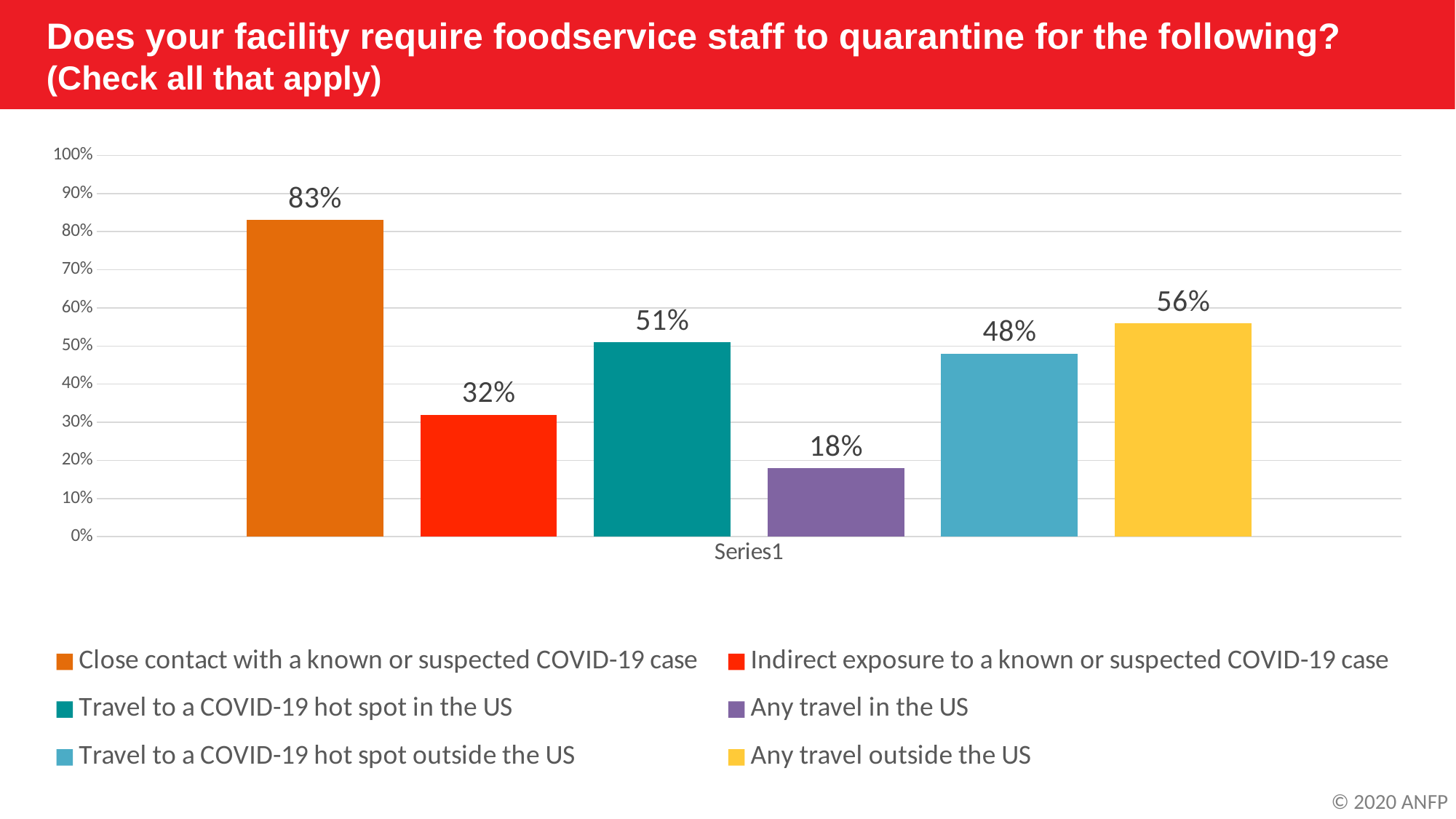
What percentage of facilities require quarantine for close contact with a known or suspected COVID-19 case? 83% Which quarantine reason has the lowest percentage? Any travel in the US What colour is the bar for any travel in the US? Purple How many bars are shown in the chart? 6 What percentage of facilities require quarantine for travel to a COVID-19 hot spot outside the US? 48% What is the difference between the percentage for close contact with a known or suspected COVID-19 case and indirect exposure to a known or suspected COVID-19 case? 51% What percentage of facilities require quarantine for any travel outside the US? 56% Is the value for indirect exposure to a known or suspected COVID-19 case greater or less than 40%? less Which quarantine reason has the highest percentage? Close contact with a known or suspected COVID-19 case Which is larger: the percentage for travel to a COVID-19 hot spot in the US or for any travel outside the US? Any travel outside the US What percentage of facilities require quarantine for any travel in the US? 18% What kind of chart is shown on the slide? Bar chart